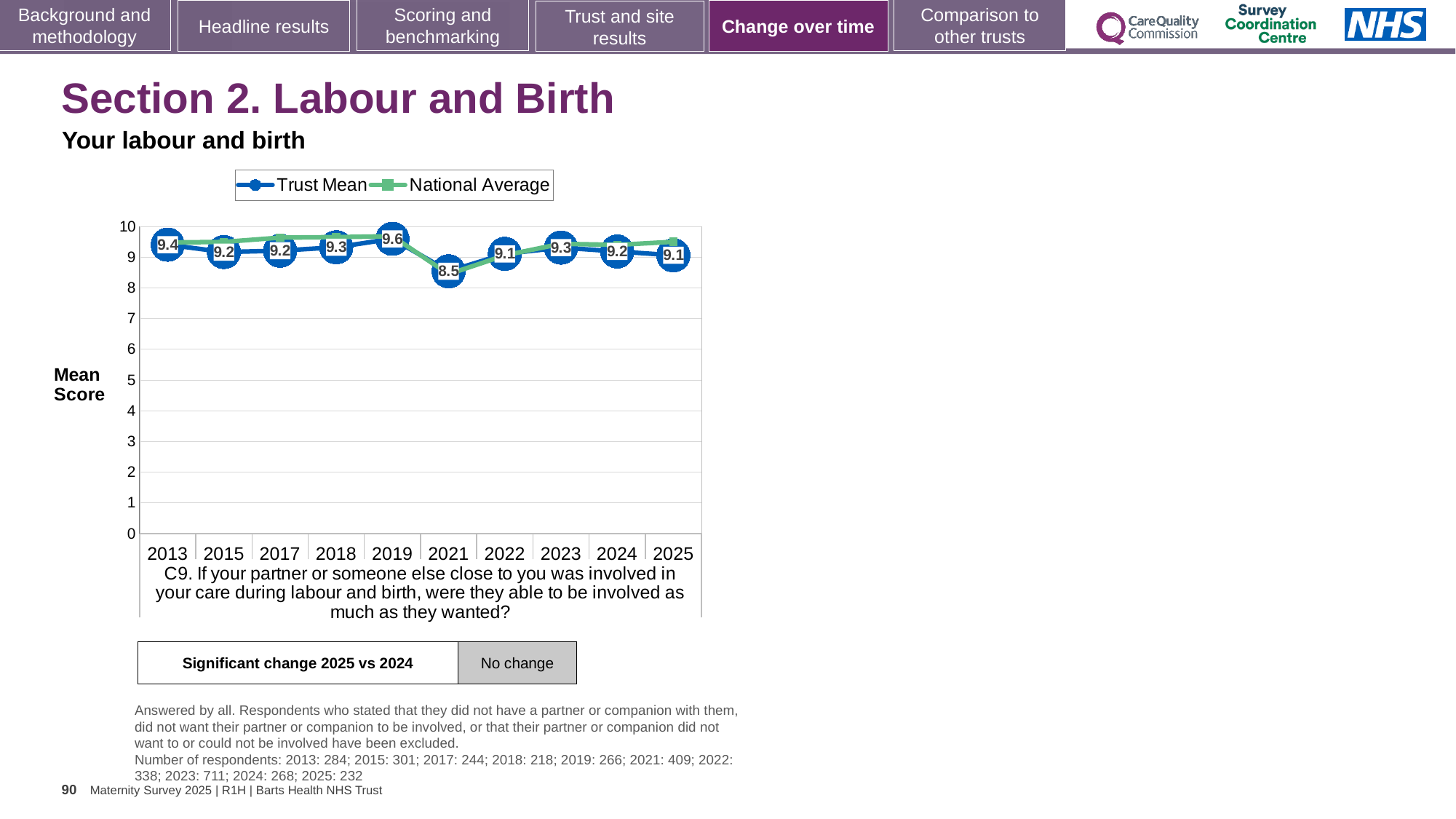
Which is larger, the Trust Mean for 2013 or for 2021? 2013 What is the Trust Mean value for 2021? 8.5 What is the difference between the Trust Mean in 2019 and in 2021? 1.1 Does the Trust Mean rise or fall from 2024 to 2025? fall What is the Trust Mean value for 2025? 9.1 What kind of chart is shown? line chart In which year is the Trust Mean lowest? 2021 How many years are shown on the x axis? 10 How many series does the legend list? 2 In which year is the Trust Mean highest? 2019 What is the Trust Mean value for 2019? 9.6 Is the National Average value for 2025 greater or less than 8? greater